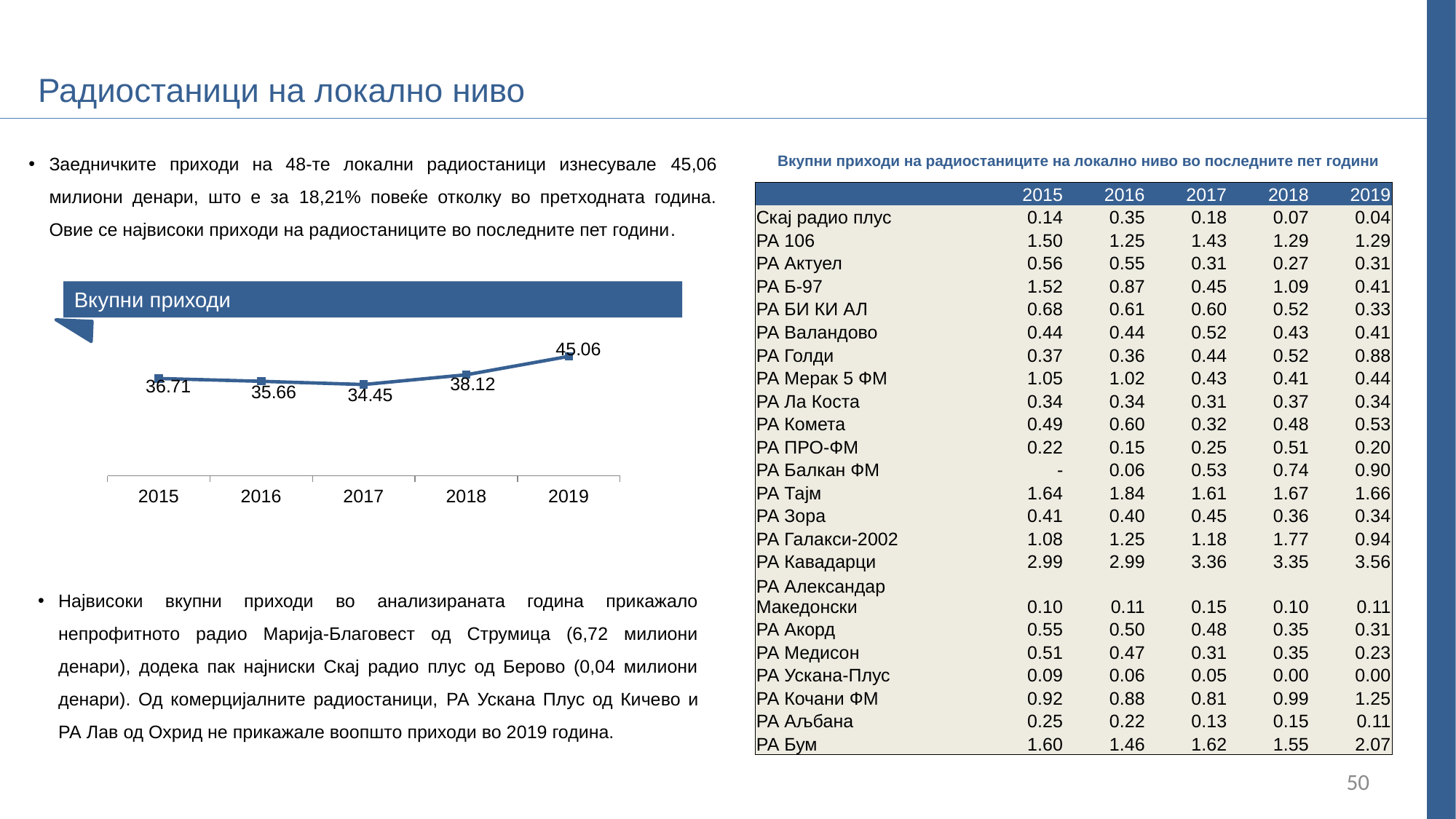
What is the difference between the 2019 and 2018 values in the "Вкупни приходи" chart? 6.94 Which year has the highest value in the "Вкупни приходи" chart? 2019 What is the value for 2015 in the "Вкупни приходи" chart? 36.71 In the "Вкупни приходи" chart, which is larger: the value for 2016 or the value for 2018? 2018 What kind of chart is the "Вкупни приходи" chart? line chart What is the title of the chart on the slide? Вкупни приходи What is the value for 2019 in the "Вкупни приходи" chart? 45.06 Which year has the lowest value in the "Вкупни приходи" chart? 2017 How many years are plotted in the "Вкупни приходи" chart? 5 What is the value for 2017 in the "Вкупни приходи" chart? 34.45 What is the difference between the 2015 and 2016 values in the "Вкупни приходи" chart? 1.05 In the "Вкупни приходи" chart, do the values rise or fall from 2017 to 2019? rise